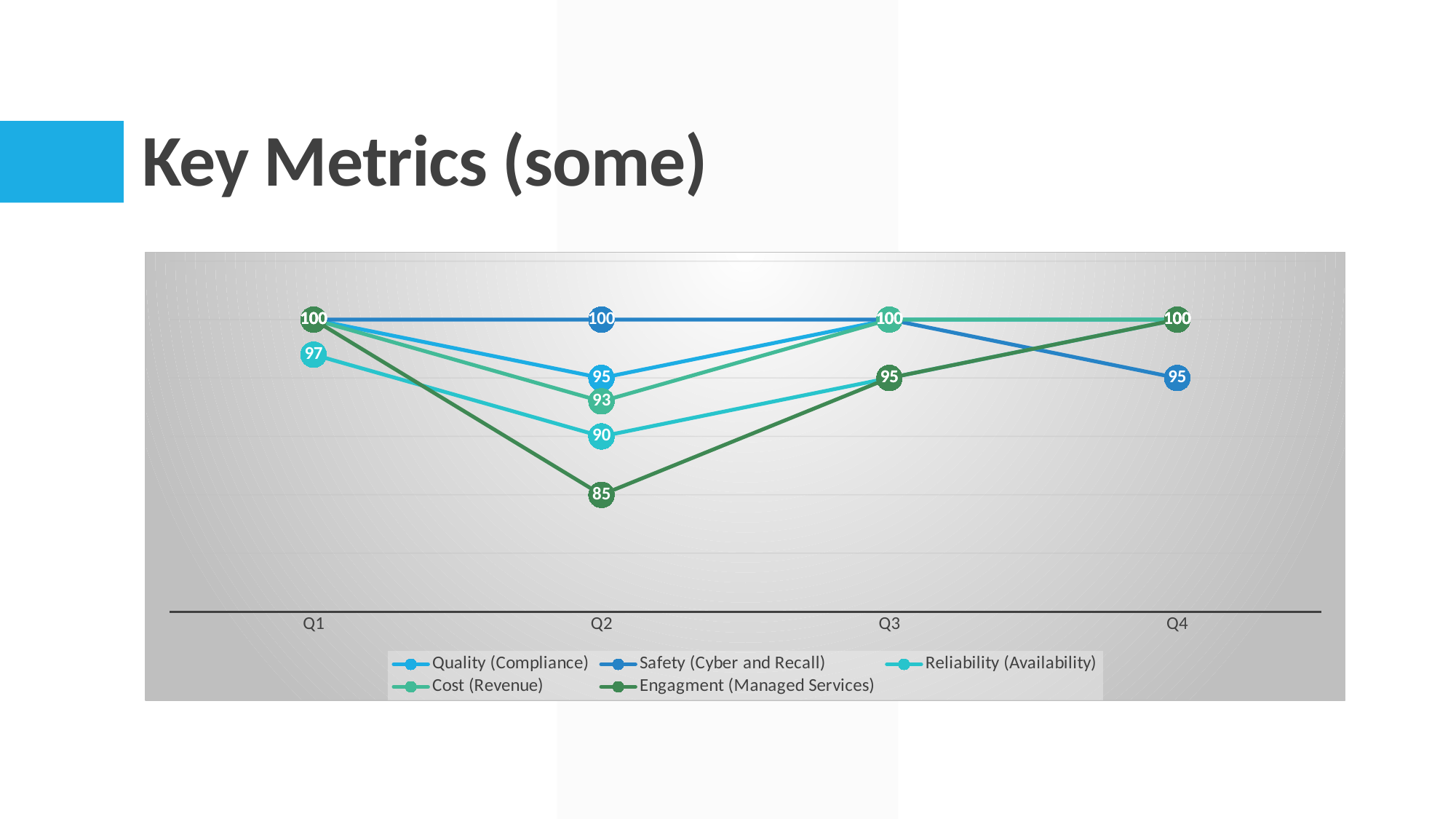
What is the value for Engagment (Managed Services) in Q2? 85 What is the title of the slide containing the chart? Key Metrics (some) What is the value for Reliability (Availability) in Q1? 97 Which series has the lowest value in Q2? Engagment (Managed Services) In Q2, which is larger: Quality (Compliance) or Cost (Revenue)? Quality (Compliance) What is the value for Cost (Revenue) in Q2? 93 What is the difference between Safety (Cyber and Recall) and Engagment (Managed Services) in Q2? 15 How many quarters are plotted along the x axis? 4 How many series does the legend list? 5 Does the Engagment (Managed Services) line rise or fall from Q2 to Q4? rise What kind of chart is shown on the slide? line chart What is the value for Safety (Cyber and Recall) in Q4? 95